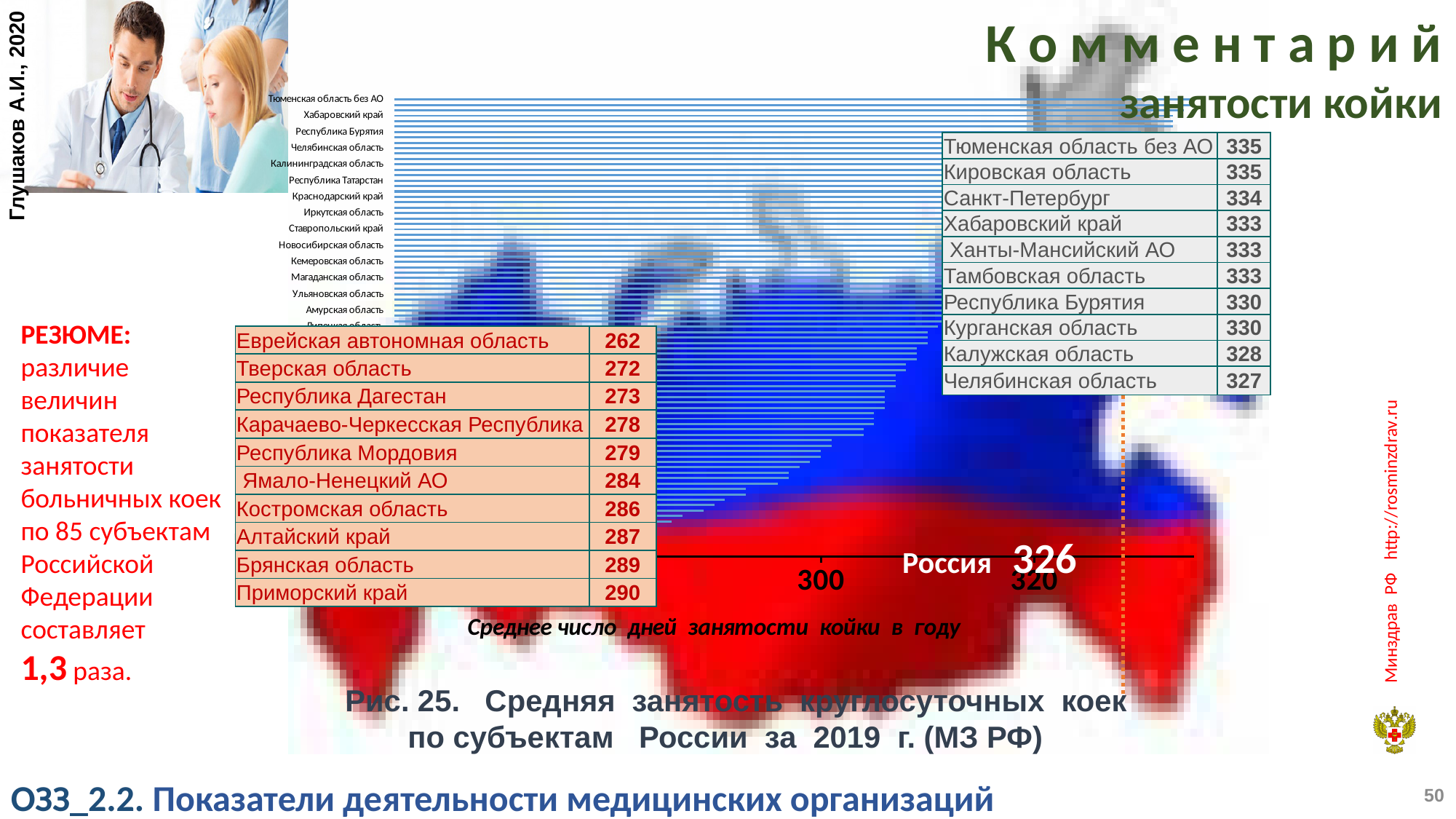
What is the figure number given in the chart caption? Рис. 25 What is the average bed occupancy value shown for Россия (Russia) as a whole? 326 What is the difference between the value for Тюменская область без АО and the value for Еврейская автономная область? 73 How many subjects (regions) of the Russian Federation does the chart cover, according to the slide text? 85 What kind of chart is shown on the slide? bar chart Which region has the lowest value on the chart? Еврейская автономная область What value is shown for Приморский край? 290 Which has the larger value, Тверская область or Приморский край? Приморский край Is the value for Россия greater or less than 320? greater What is the label of the horizontal axis of the chart? Среднее число дней занятости койки в году What value is shown for Еврейская автономная область? 262 What value is shown for Санкт-Петербург? 334